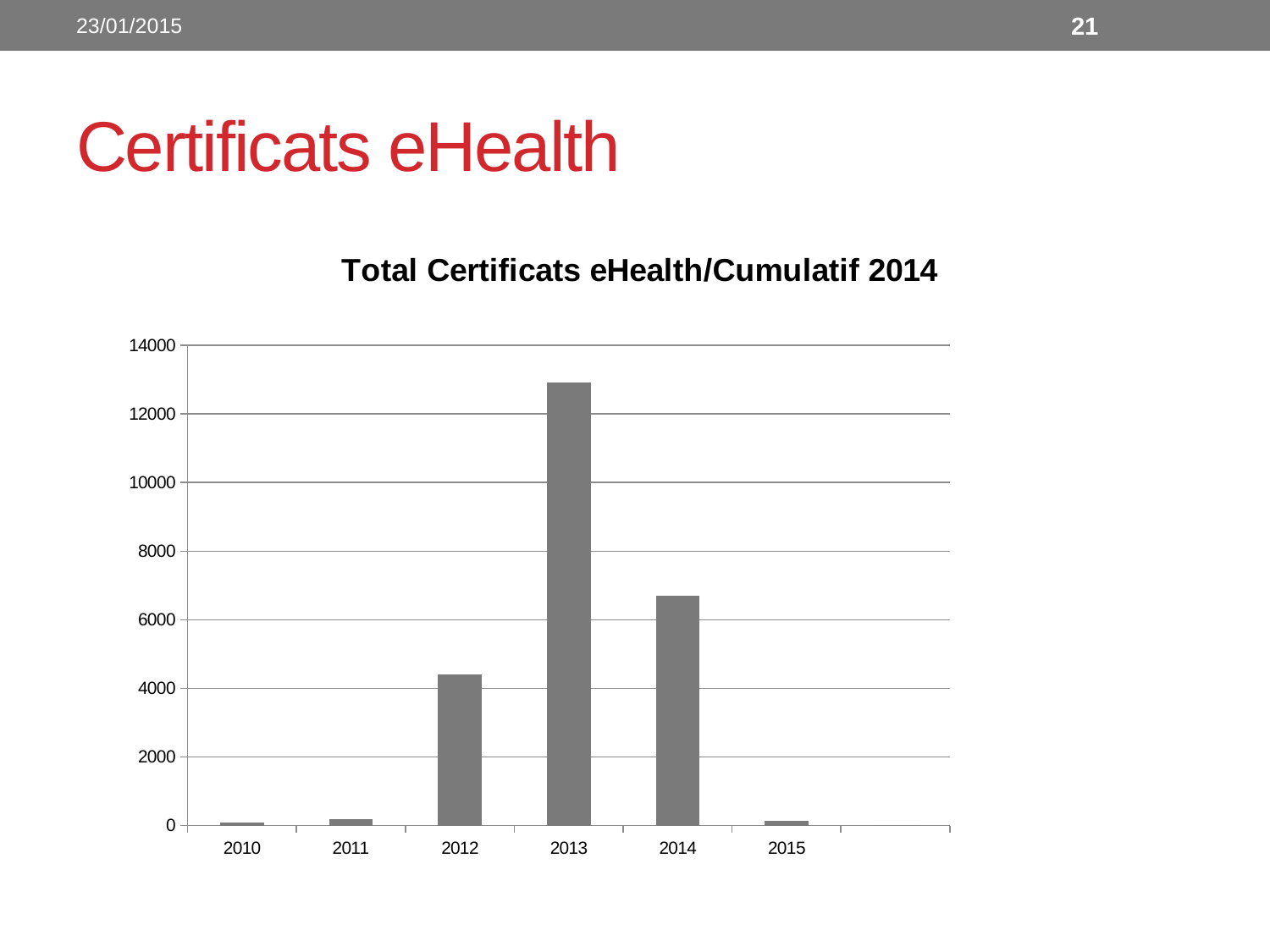
How many years are shown on the x axis of the chart? 6 Do the values rise or fall from 2013 to 2015? fall What is the highest value shown on the y axis? 14000 Is the value for 2011 greater or less than 2000? less What type of chart is shown on the slide? bar chart Which is larger, the value for 2012 or the value for 2014? 2014 Which year has the highest value? 2013 Which is larger, the value for 2013 or the value for 2014? 2013 Is the value for 2014 greater or less than 6000? greater Is the value for 2013 greater or less than 12000? greater What is the title of the chart? Total Certificats eHealth/Cumulatif 2014